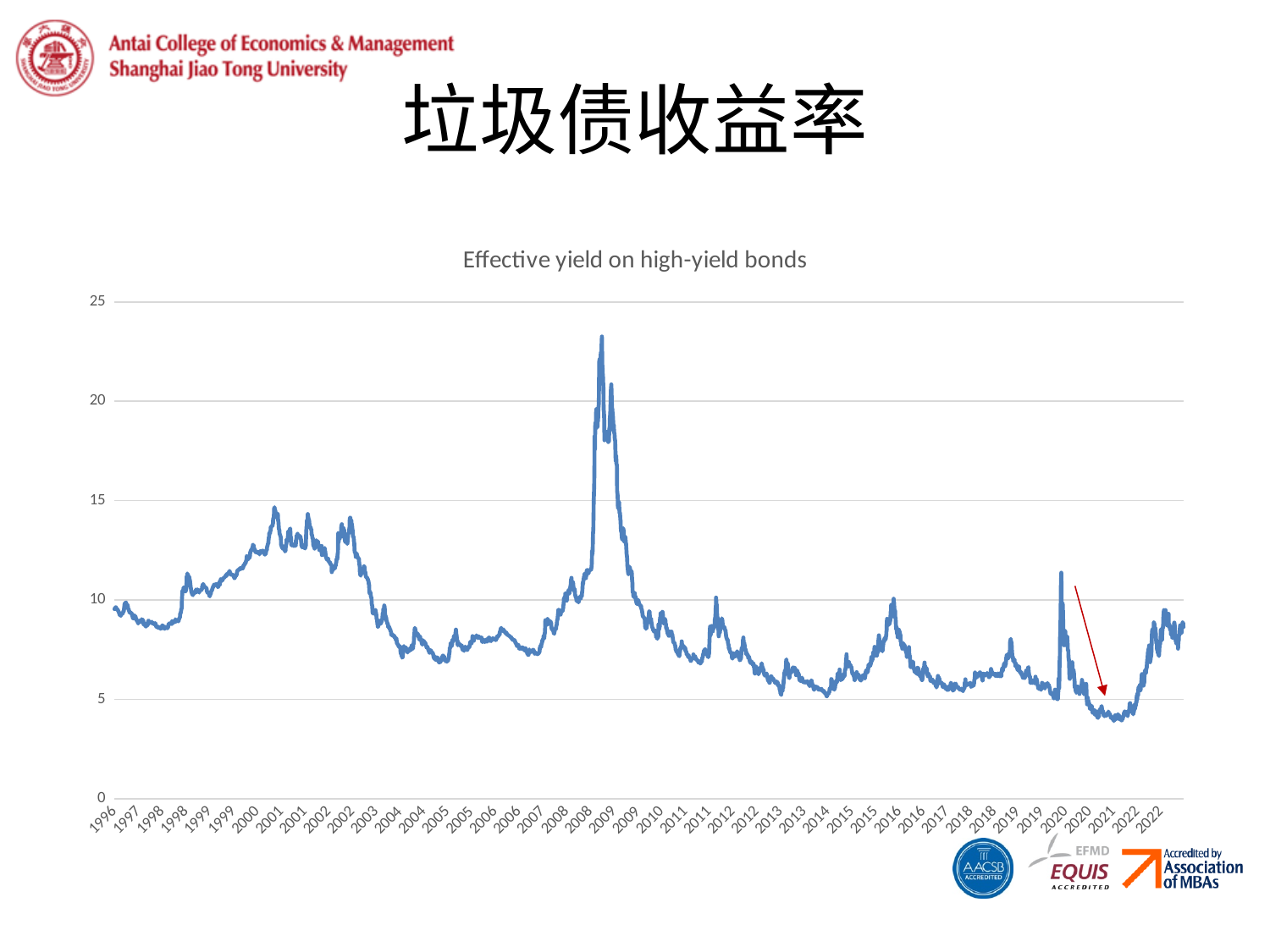
Which is higher: the peak of the line around 2008-2009 or the spike around 2020? the peak around 2008-2009 What kind of chart is shown on the slide? line chart What is the title of the chart? Effective yield on high-yield bonds Is the value of the line around 2000 greater or less than 10? greater What is the first year shown on the horizontal axis? 1996 How many data series are plotted in the chart? 1 Is the value of the line around 2013 greater or less than 10? less What is the highest value shown on the vertical axis? 25 Does the line rise or fall between the 2020 spike and 2021? fall Does the line rise or fall from 2021 to 2022? rise Is the highest value reached by the line greater or less than 20? greater